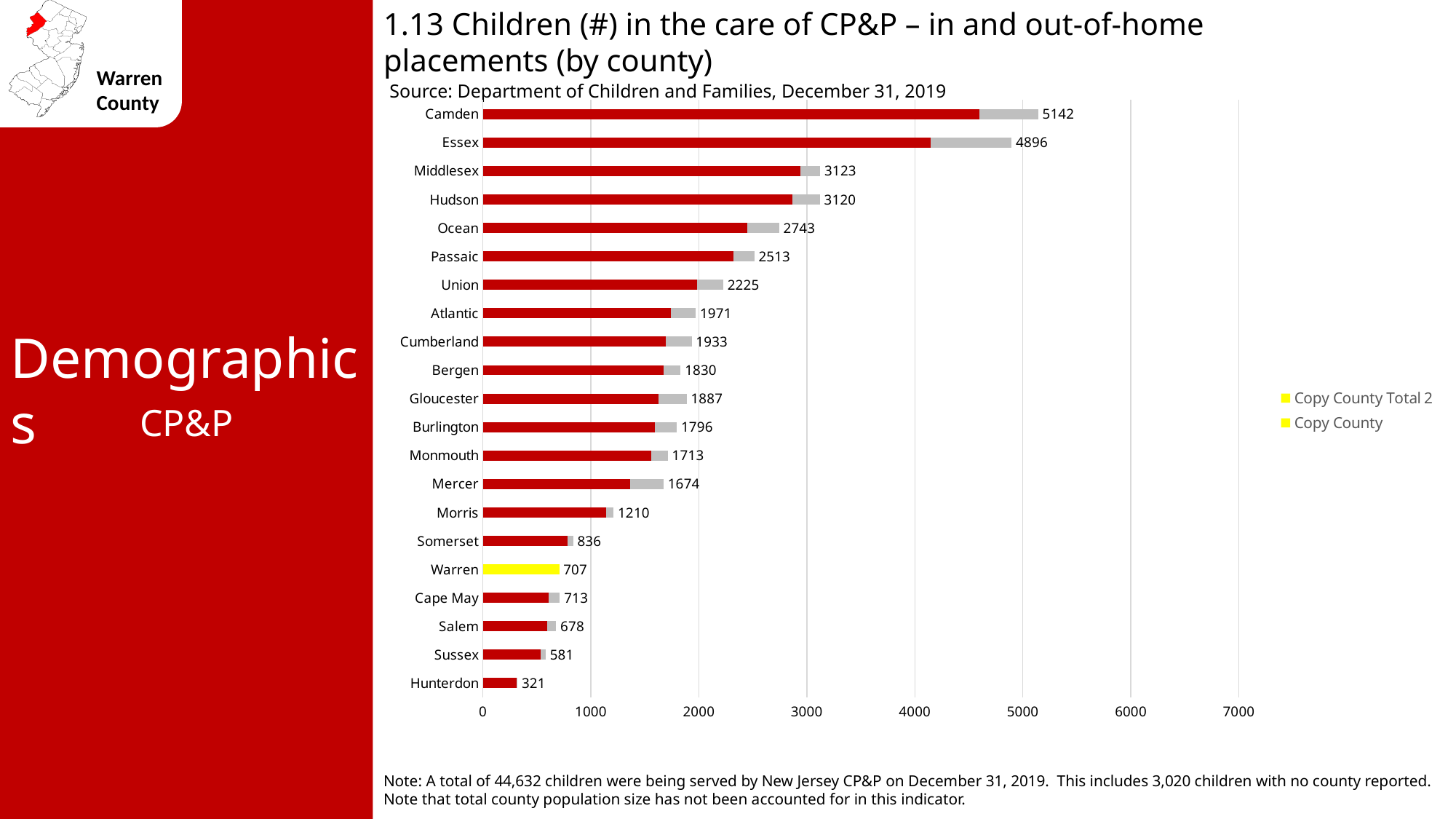
What is the total number of children in the care of CP&P for Camden county? 5142 What kind of chart is shown on the slide? Bar chart Which county has the lowest total number of children in the care of CP&P? Hunterdon What is the difference between the totals for Camden and Essex? 246 Which county has a larger total, Ocean or Passaic? Ocean Which county has the highest total number of children in the care of CP&P? Camden How many entries does the legend list? 2 What is the total number of children in the care of CP&P for Warren county? 707 Which county's bar is highlighted in yellow? Warren How many counties are shown in the chart? 21 What is the difference between the totals for Morris and Somerset? 374 What is the total number of children in the care of CP&P for Morris county? 1210